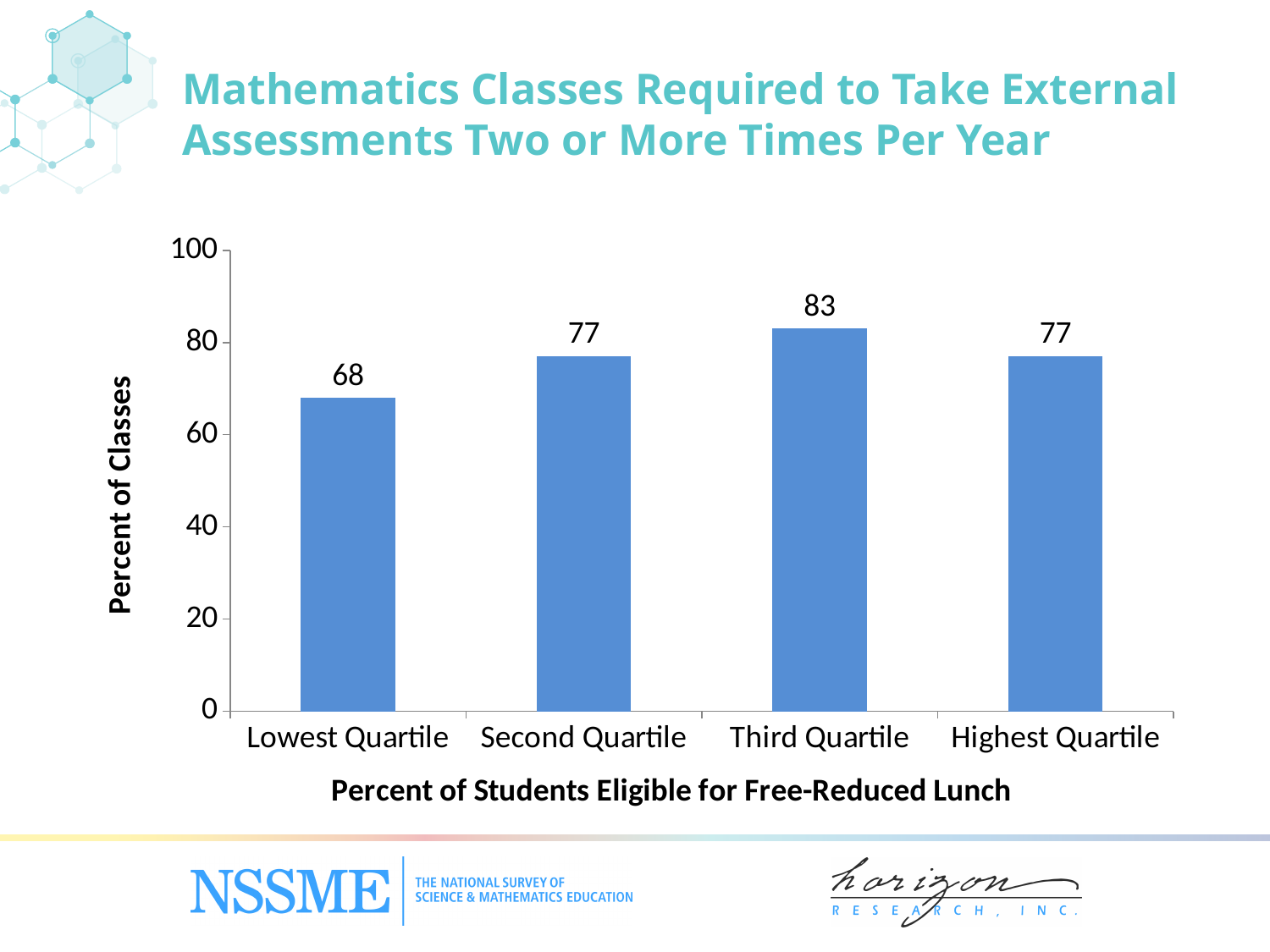
Which quartile has the highest percent of classes? Third Quartile What kind of chart is shown on the slide? bar chart What is the value for Third Quartile? 83 How many categories are shown on the x axis? 4 What is the value for Highest Quartile? 77 Is the value for Third Quartile greater or less than 80? greater What is the value for Lowest Quartile? 68 Which is larger, the value for Second Quartile or the value for Lowest Quartile? Second Quartile What is the label of the y axis? Percent of Classes Which quartile has the lowest percent of classes? Lowest Quartile What is the difference between the values for Second Quartile and Lowest Quartile? 9 What is the difference between the values for Third Quartile and Lowest Quartile? 15